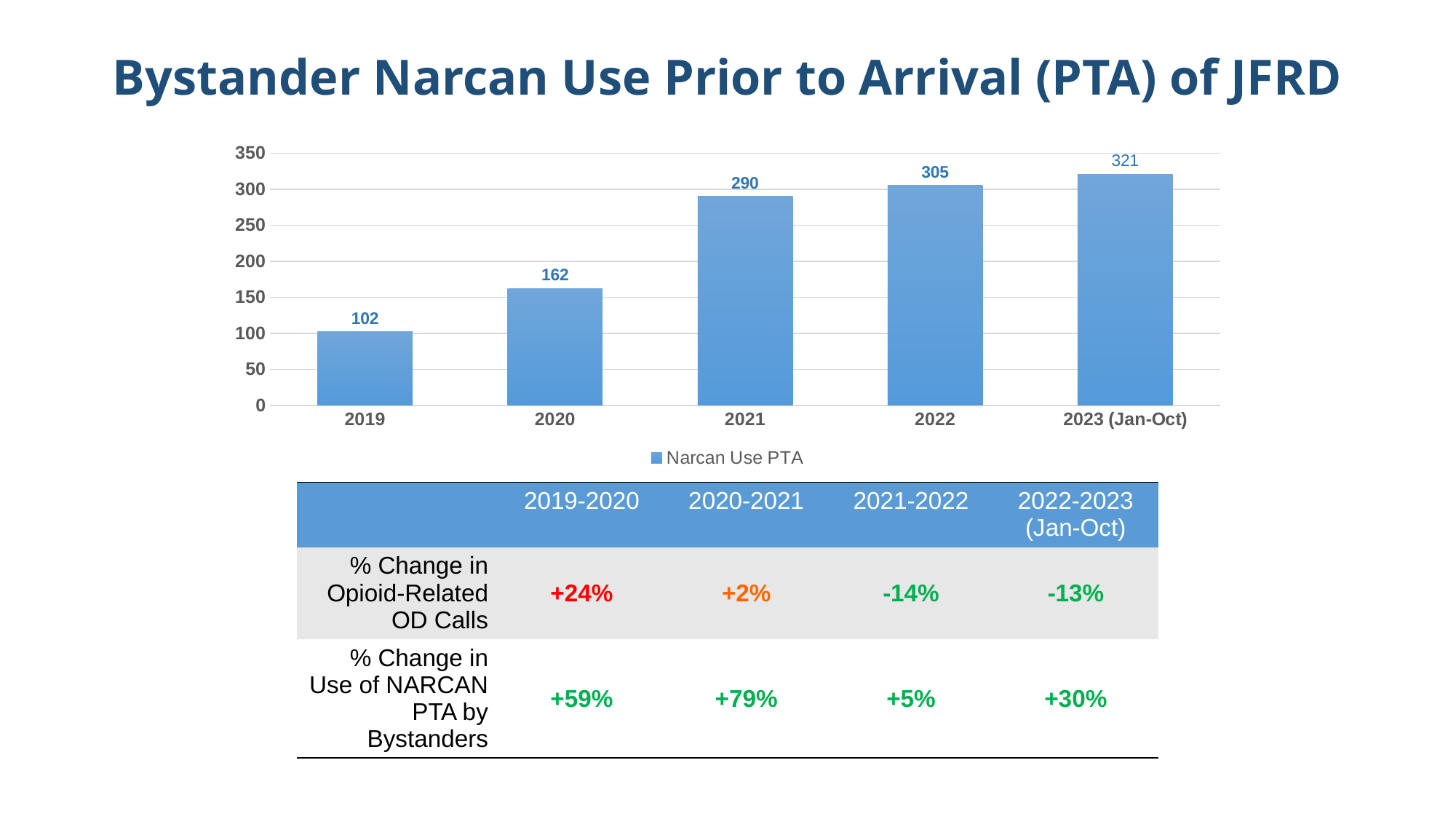
How many years are shown on the x axis of the chart? 5 What is the value for Narcan Use PTA in 2019? 102 What is the difference between the Narcan Use PTA values for 2021 and 2020? 128 What is the difference between the Narcan Use PTA values for 2020 and 2019? 60 Is the value for 2020 greater or less than 150? greater Which year has the lowest Narcan Use PTA value? 2019 Do the Narcan Use PTA values rise or fall from 2019 to 2023 (Jan-Oct)? rise What is the value for Narcan Use PTA in 2023 (Jan-Oct)? 321 What is the value for Narcan Use PTA in 2021? 290 What kind of chart is shown on the slide? bar chart Which year has the highest Narcan Use PTA value? 2023 (Jan-Oct) Which is larger, the Narcan Use PTA value for 2022 or for 2021? 2022